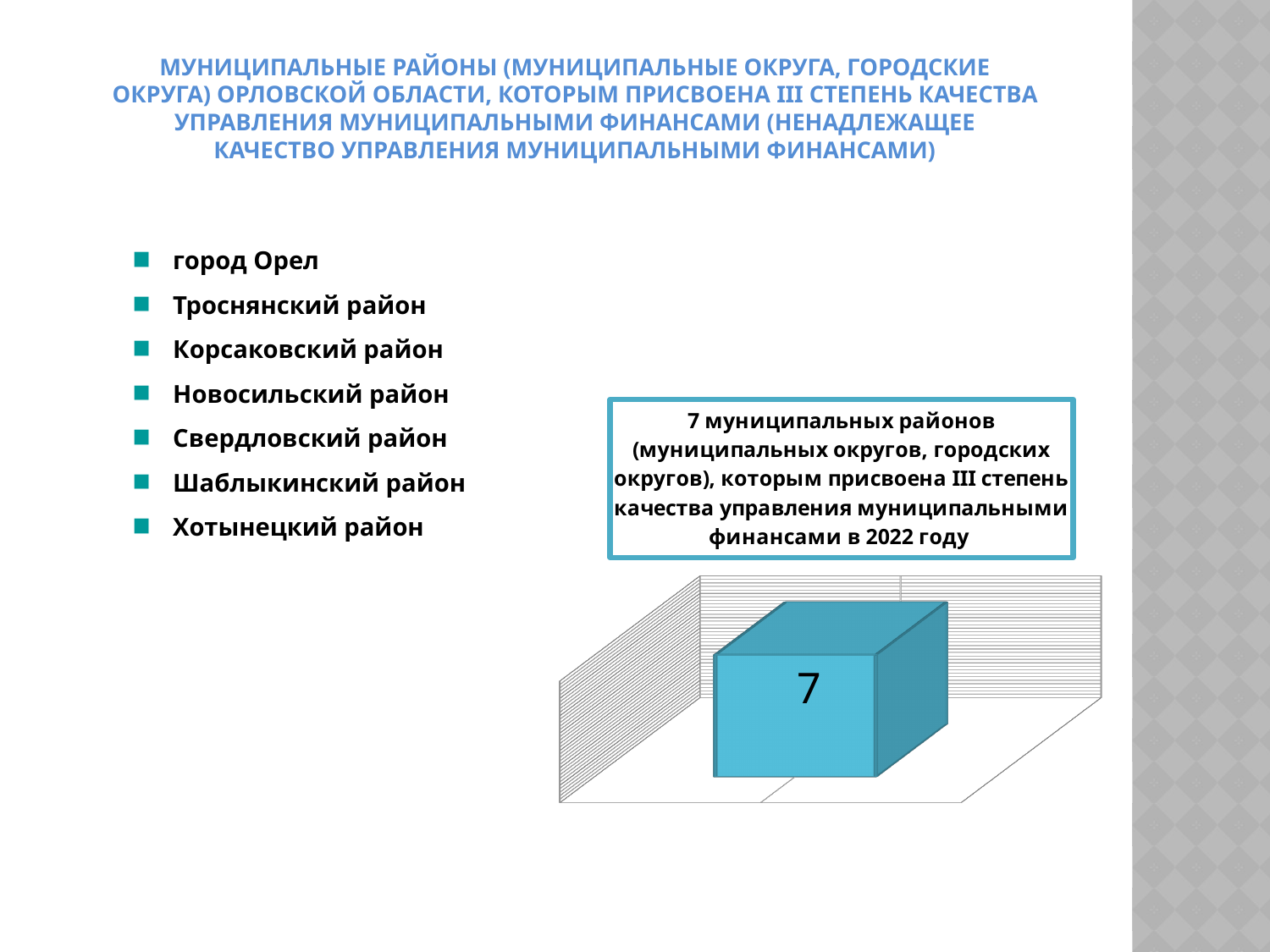
What kind of chart is shown on the slide? bar chart What value is printed on the bar in the chart? 7 What colour is the bar in the chart? blue How many bars does the chart show? 1 According to the text box above the chart, which year does the value of 7 refer to? 2022 Is the value shown on the bar greater or less than 5? greater